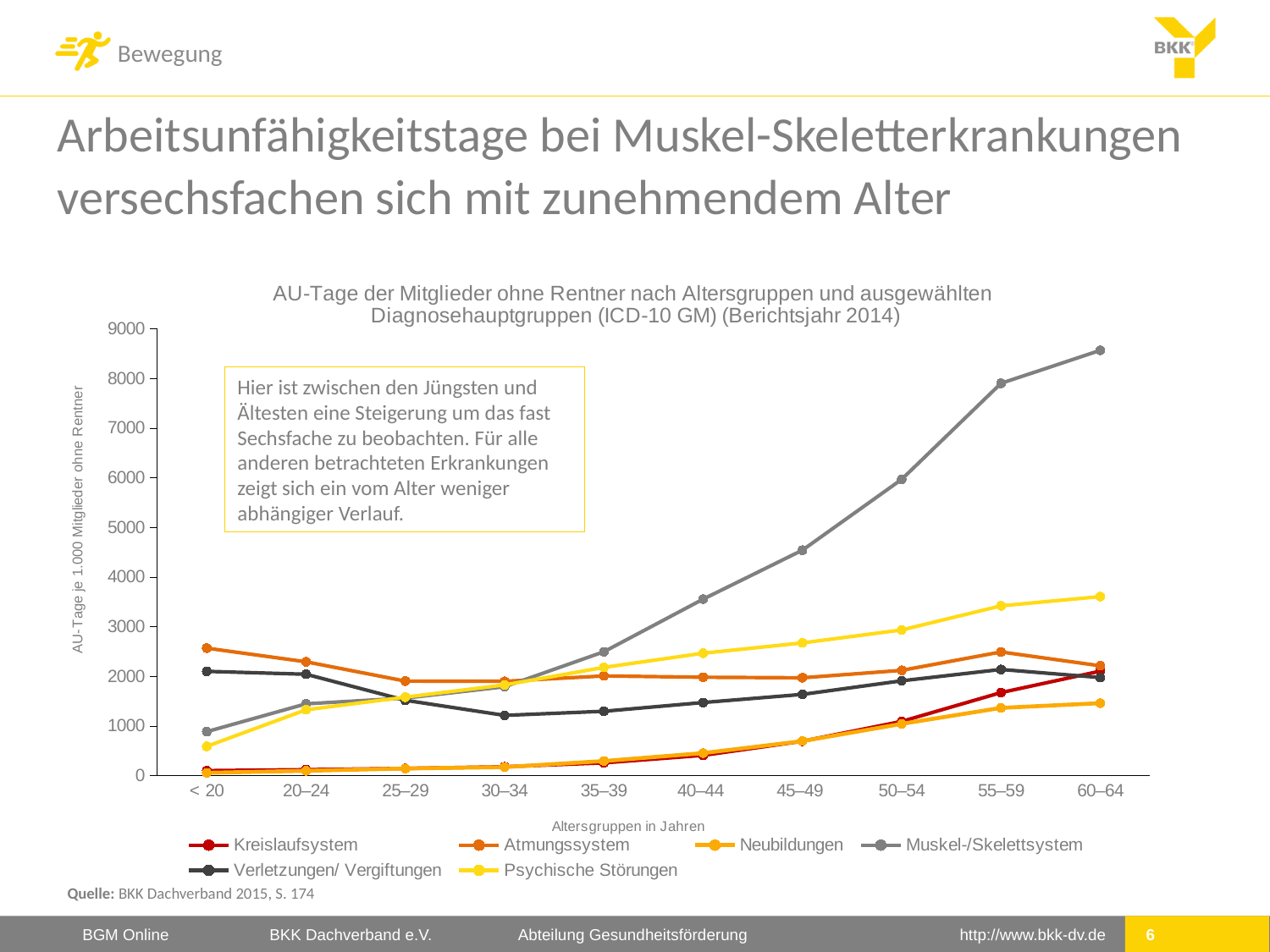
In the 60–64 age group, which is larger: Psychische Störungen or Atmungssystem? Psychische Störungen Is the value for Psychische Störungen in the 60–64 age group greater or less than 3000? greater What is the label of the y axis? AU-Tage je 1.000 Mitglieder ohne Rentner How many age groups are shown on the x axis? 10 How many series does the legend list? 6 Which series has the highest value in the < 20 age group? Atmungssystem Is the value for Muskel-/Skelettsystem in the < 20 age group greater or less than 1000? less In which age group does the Muskel-/Skelettsystem series reach its highest value? 60–64 What kind of chart is shown on the slide? line chart Is the value for Muskel-/Skelettsystem in the 60–64 age group greater or less than 8000? greater Does the Muskel-/Skelettsystem series rise or fall as age increases from < 20 to 60–64? rise Which series has the highest value in the 60–64 age group? Muskel-/Skelettsystem